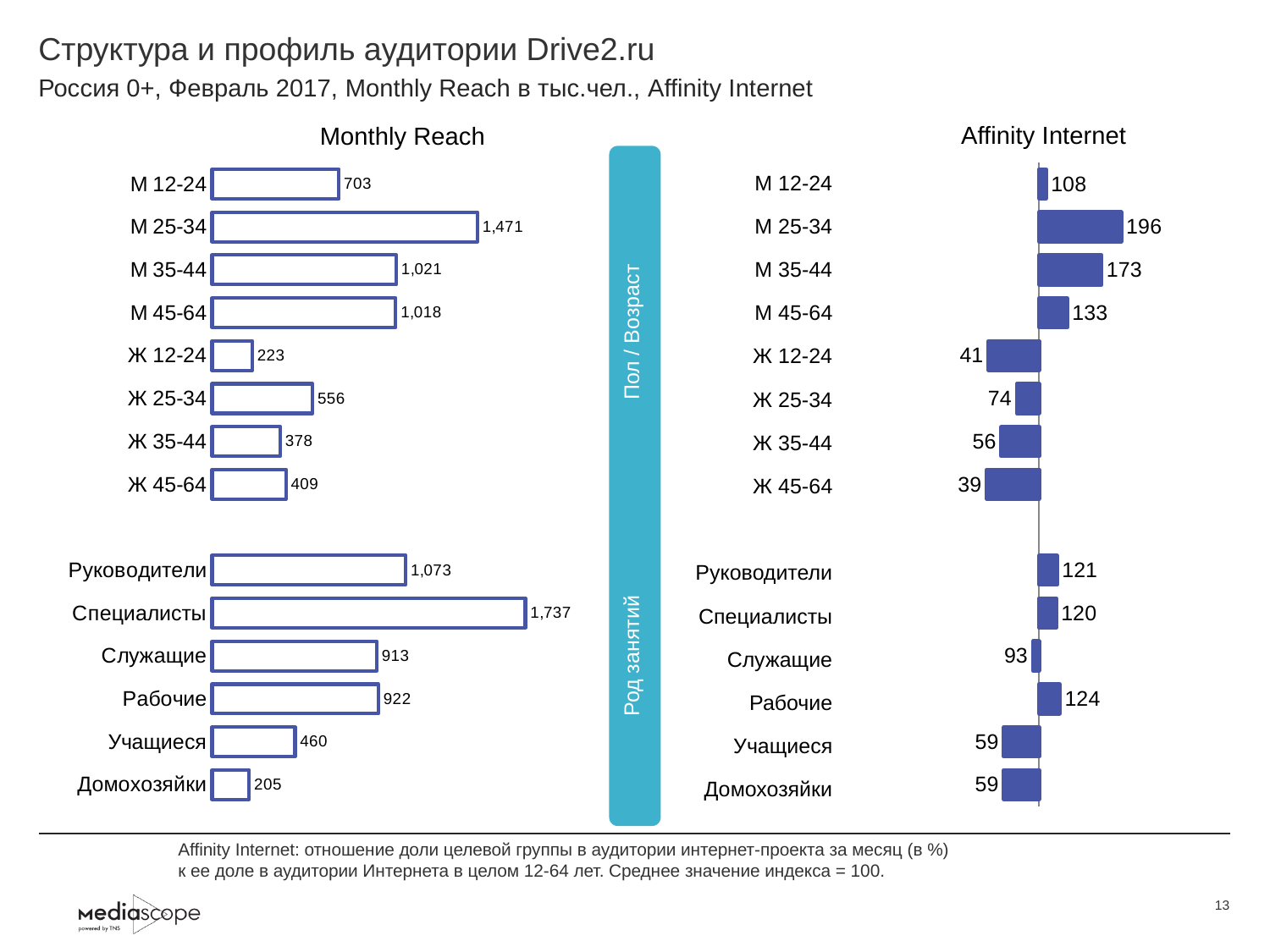
What type of chart is the Affinity Internet chart? Bar chart In the Affinity Internet chart, which category has the lowest value? Ж 45-64 In the Affinity Internet chart, what is the value for М 35-44? 173 In the Monthly Reach chart, which category has the lowest value? Домохозяйки In the Monthly Reach chart, which is larger: Ж 25-34 or Ж 45-64? Ж 25-34 How many categories are plotted in the Monthly Reach chart? 14 In the Affinity Internet chart, what is the difference between Рабочие and Служащие? 31 In the Affinity Internet chart, which is larger: Руководители or Специалисты? Руководители In the Monthly Reach chart, which category has the highest value? Специалисты In the Affinity Internet chart, which category has the highest value? М 25-34 In the Monthly Reach chart, what is the difference between Руководители and Служащие? 160 In the Monthly Reach chart, what is the value for М 25-34? 1,471